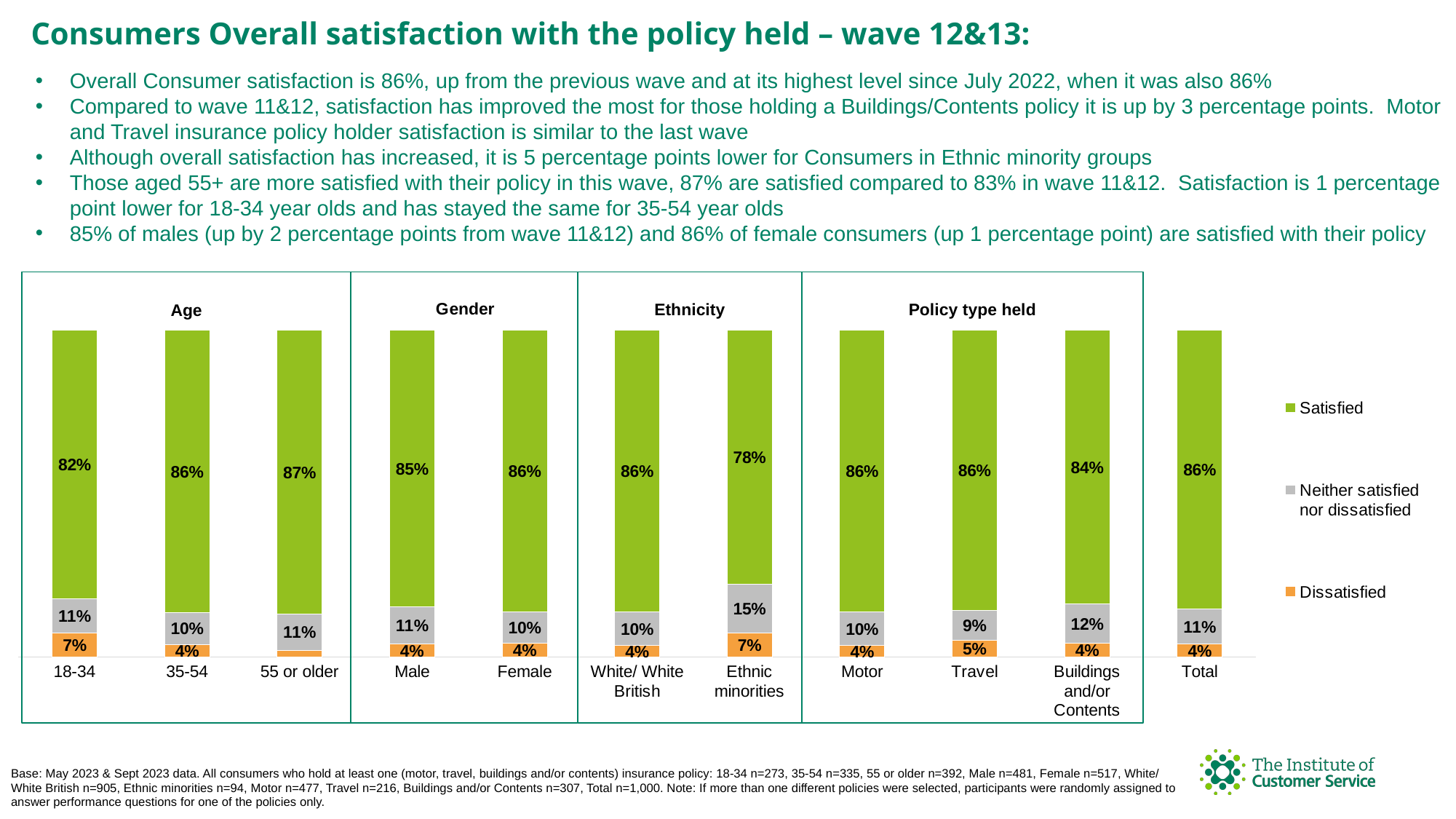
What percentage of consumers aged 18-34 are satisfied with their policy? 82% What is the difference in Satisfied percentage between White/ White British and Ethnic minorities? 8 percentage points How many categories are shown along the x axis of the chart? 11 What kind of chart is shown on the slide? Stacked bar chart Which category has the highest Satisfied percentage? 55 or older What is the Dissatisfied value for Travel policy holders? 5% Which category has the lowest Satisfied percentage? Ethnic minorities What is the Neither satisfied nor dissatisfied value for Buildings and/or Contents policy holders? 12% What is the Dissatisfied value for Ethnic minorities? 7% Which has a higher Satisfied percentage, Male or Female? Female Which colour represents the Satisfied series in the chart? Green How many series does the legend list? 3